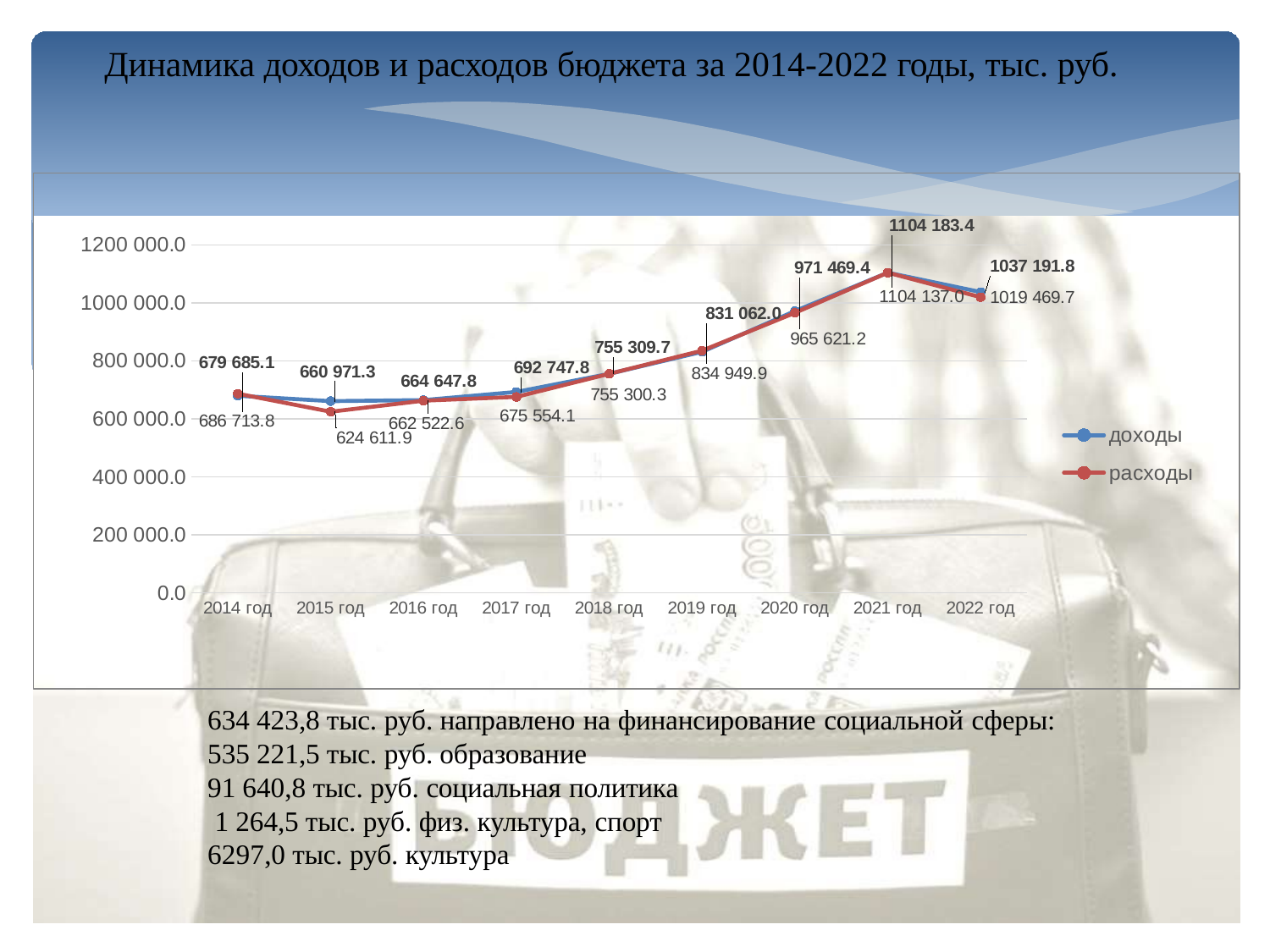
What is the value of доходы for 2021 год? 1104 183.4 What is the value of расходы for 2015 год? 624 611.9 What is the difference between доходы and расходы in 2015 год? 36 359.4 In which year is доходы highest? 2021 год Is the value of расходы for 2019 год greater or less than 800 000.0? greater What is the difference between доходы and расходы in 2022 год? 17 722.1 In which year is расходы lowest? 2015 год What kind of chart is shown on the slide? line chart What is the value of расходы for 2022 год? 1019 469.7 Which is larger in 2020 год, доходы or расходы? доходы How many years are shown on the x axis? 9 How many series does the legend list? 2